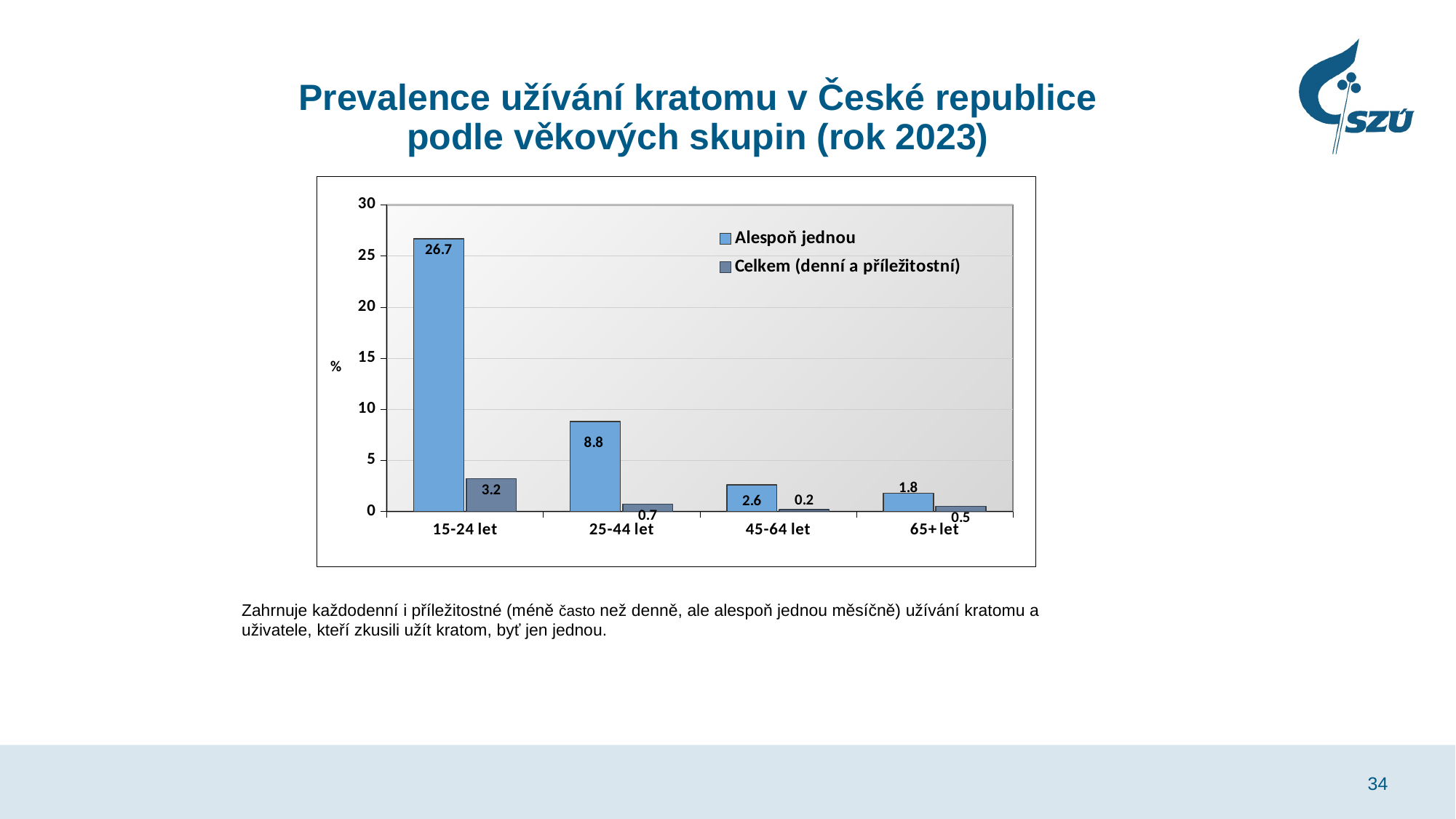
Which age group has the highest value for 'Alespoň jednou'? 15-24 let Do the 'Alespoň jednou' values rise or fall from the youngest to the oldest age group? fall What is the difference between the 'Alespoň jednou' values for 15-24 let and 25-44 let? 17.9 Which age group has the lowest value for 'Celkem (denní a příležitostní)'? 45-64 let What is the value for 'Alespoň jednou' in the 15-24 let age group? 26.7 What is the value for 'Celkem (denní a příležitostní)' in the 25-44 let age group? 0.7 What kind of chart is shown on the slide? bar chart How many age groups are shown on the x axis? 4 Is the 'Alespoň jednou' value for 25-44 let greater or less than 10? less Which is larger: the 'Celkem (denní a příležitostní)' value for 15-24 let or for 65+ let? 15-24 let What is the value for 'Alespoň jednou' in the 65+ let age group? 1.8 How many series does the legend list? 2